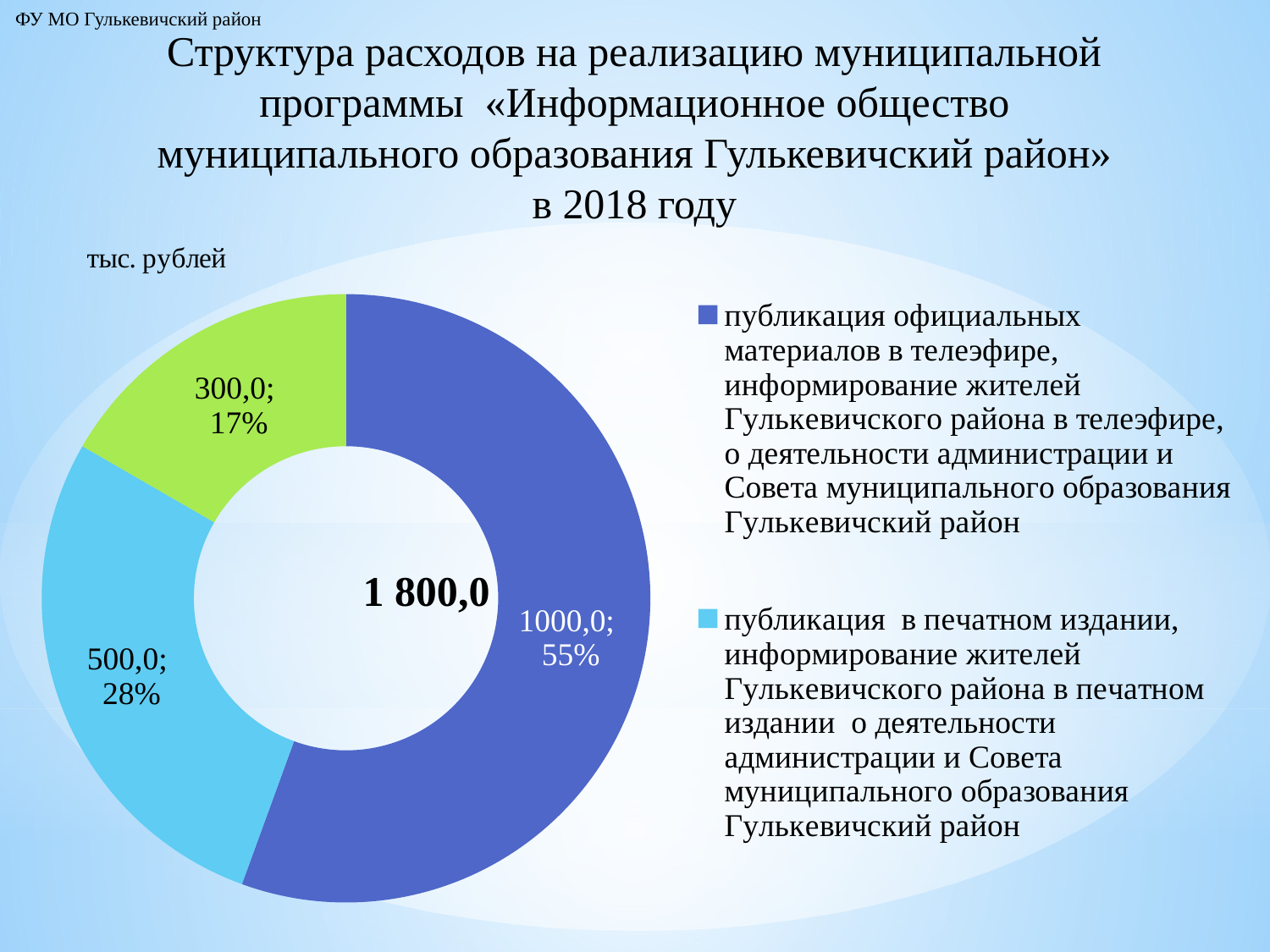
What is the value for the slice labelled «публикация официальных материалов в телеэфире...» (dark blue)? 1000,0 What is the value for the slice labelled «публикация в печатном издании...» (light blue)? 500,0 What type of chart is shown on the slide? doughnut (pie) chart What share of the chart does the dark blue slice (публикация официальных материалов в телеэфире) represent? 55% What share of the chart does the green slice represent? 17% What is the difference between the dark blue slice (1000,0) and the light blue slice (500,0)? 500,0 What is the value shown for the green slice of the chart? 300,0 What total value is shown in the centre of the doughnut chart? 1 800,0 Which slice of the chart has the largest value? публикация официальных материалов в телеэфире (1000,0) How many entries does the legend list? 2 Which slice of the chart has the smallest value? the green slice (300,0) What share of the chart does the light blue slice (публикация в печатном издании) represent? 28%